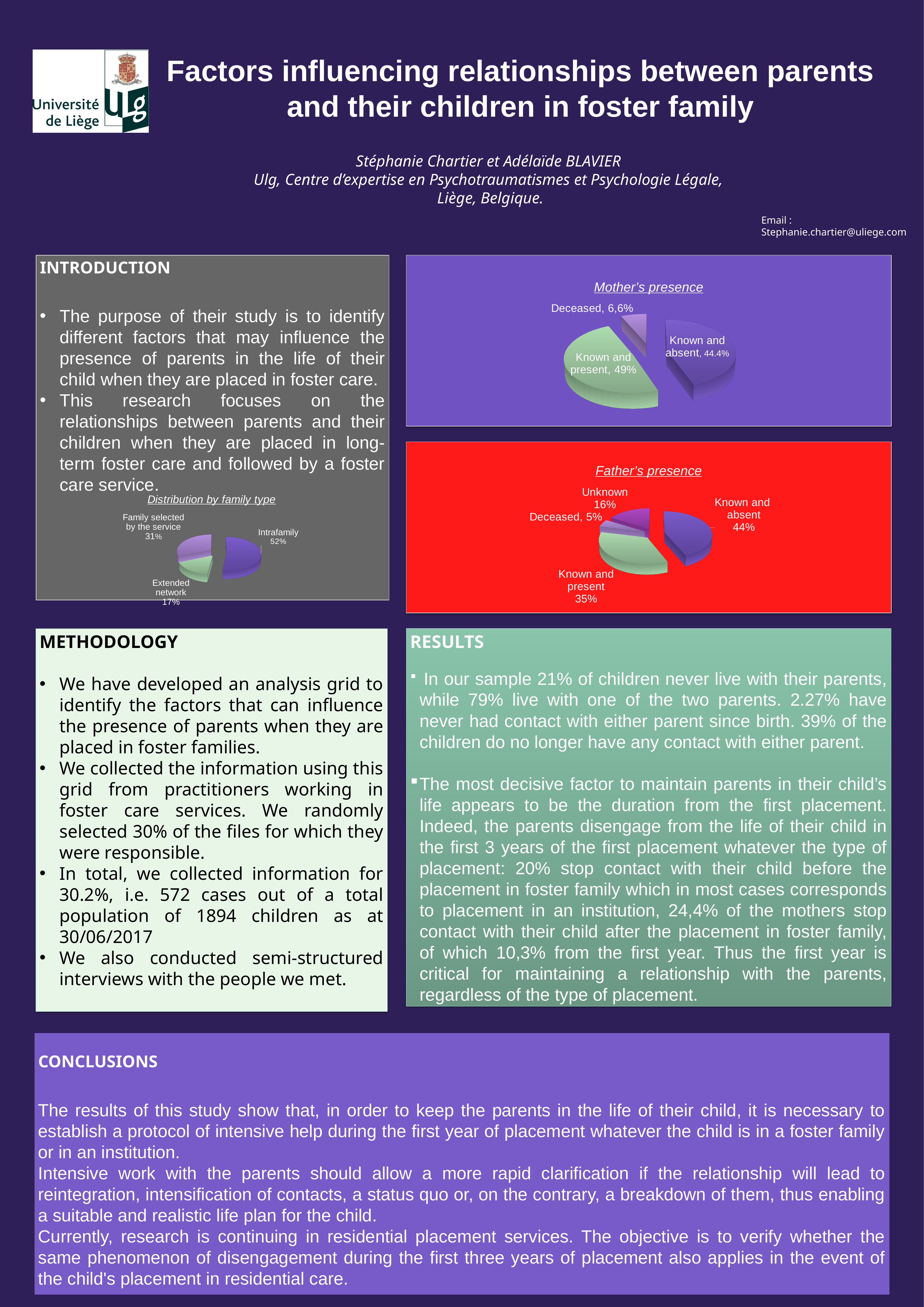
In the 'Father's presence' chart, what is the difference between the 'Known and absent' and 'Known and present' shares? 9% What kind of chart is the 'Distribution by family type' chart? Pie chart In the 'Mother's presence' chart, what share is labelled 'Deceased'? 6,6% In the 'Father's presence' chart, which is larger: 'Unknown' or 'Deceased'? Unknown In the 'Distribution by family type' chart, which category has the smallest share? Extended network In the 'Mother's presence' chart, how many slices does the pie have? 3 In the 'Mother's presence' chart, which category has the smallest slice? Deceased In the 'Father's presence' chart, which category has the largest slice? Known and absent In the 'Father's presence' chart, how many categories are shown? 4 In the 'Father's presence' chart, what share is labelled 'Unknown'? 16% In the 'Mother's presence' chart, what share is labelled 'Known and present'? 49% In the 'Distribution by family type' chart, what share is labelled 'Intrafamily'? 52%